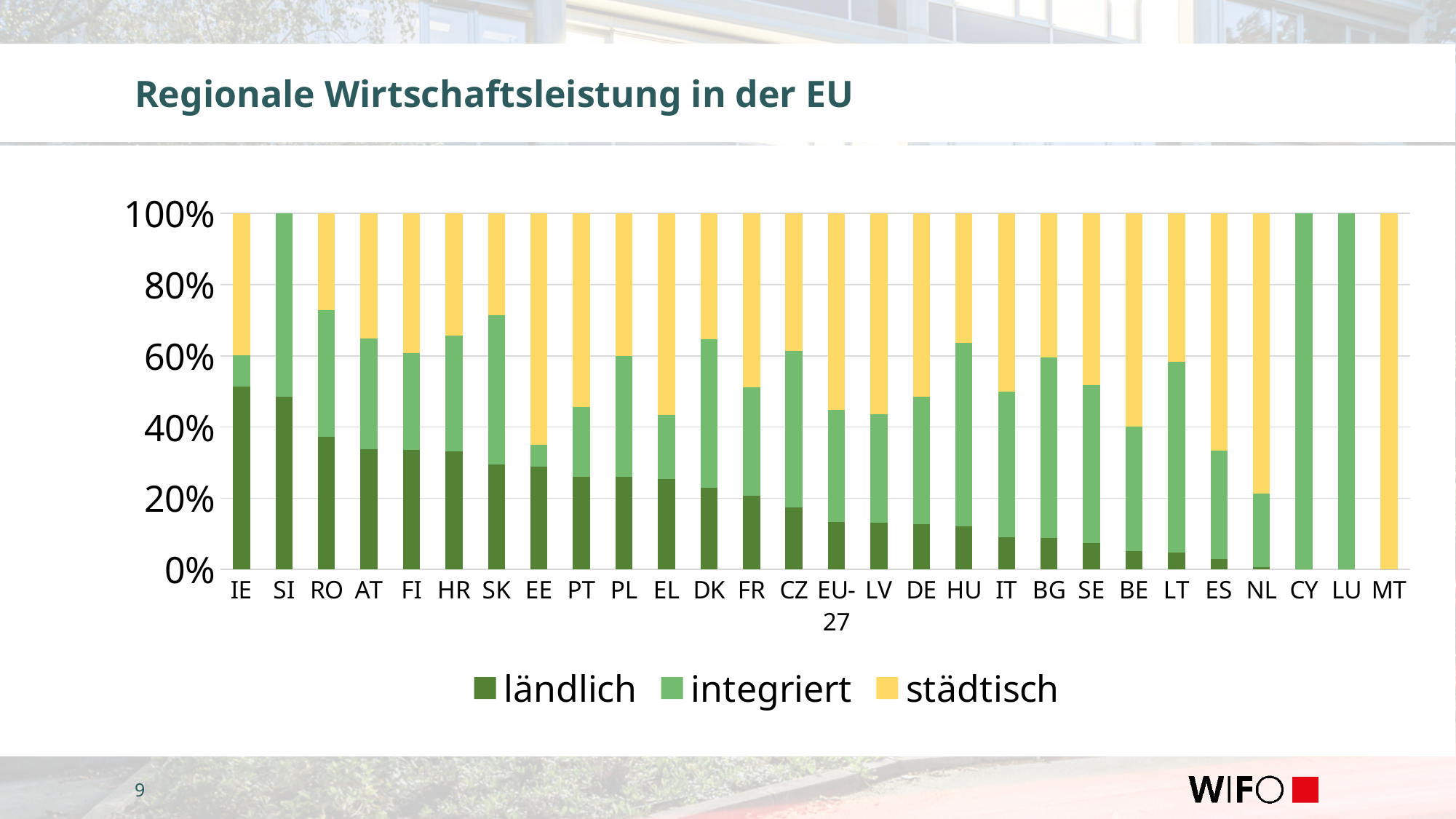
What is the title of the chart? Regionale Wirtschaftsleistung in der EU Is the 'ländlich' value for IE greater or less than 40%? greater How many series does the legend list? 3 How many categories are shown on the x axis? 28 Is the 'ländlich' value for ES greater or less than 20%? less Which has the larger 'ländlich' share, IE or ES? IE What kind of chart is shown on the slide? stacked bar chart Does the 'ländlich' share rise or fall along the x axis from IE to MT? fall What is the total of the stacked bar for AT? 100% Which category has the largest 'städtisch' share? MT Which colour represents the series 'städtisch' in the legend? yellow Which has the larger 'städtisch' share, NL or SI? NL